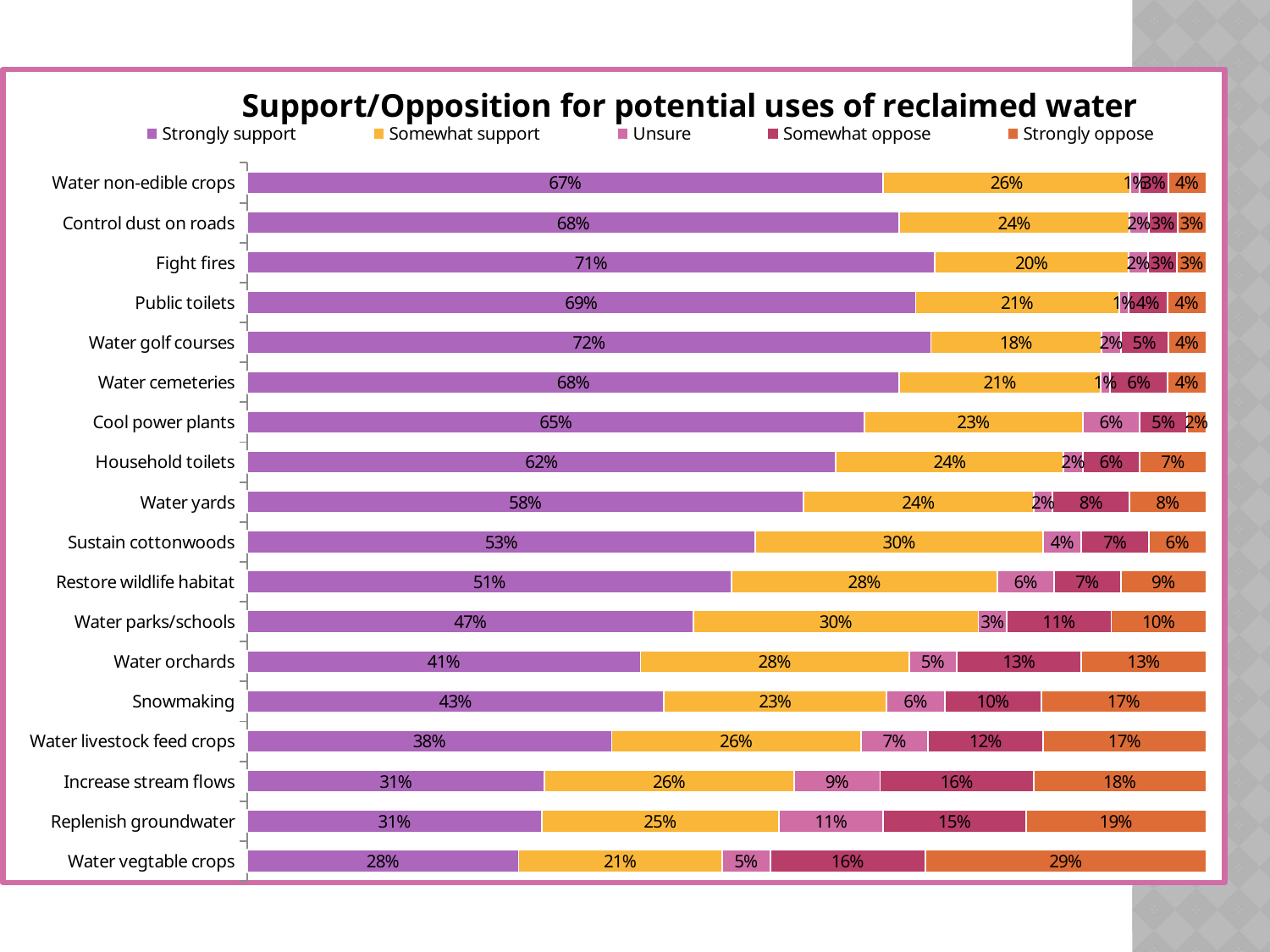
Which use has the lowest Strongly support percentage? Water vegtable crops What is the difference between the Strongly support values for Water golf courses and Water orchards? 31% How many series does the legend list? 5 What is the Unsure value for Replenish groundwater? 11% What percentage strongly support using reclaimed water to fight fires? 71% How many uses of reclaimed water are listed on the chart? 18 What percentage strongly oppose using reclaimed water for Water vegtable crops? 29% What is the Somewhat support value for Sustain cottonwoods? 30% Which has a larger Strongly oppose value, Snowmaking or Water parks/schools? Snowmaking What kind of chart is shown on the slide? Stacked bar chart Which use has the highest Strongly support percentage? Water golf courses What is the title of the chart? Support/Opposition for potential uses of reclaimed water